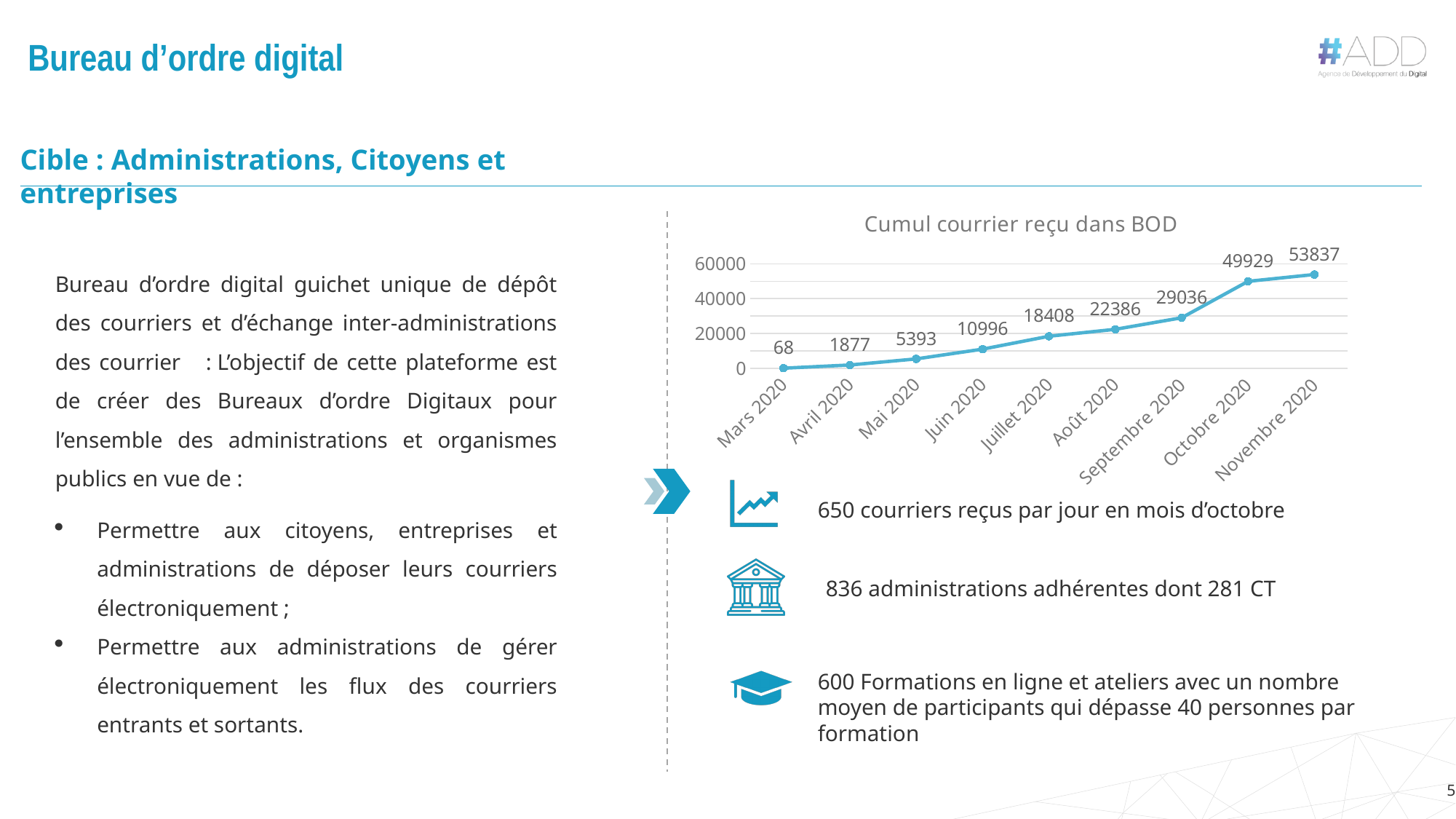
Which month has the highest value in the chart 'Cumul courrier reçu dans BOD'? Novembre 2020 What is the value for Juillet 2020 in the chart 'Cumul courrier reçu dans BOD'? 18408 Do the values in the chart 'Cumul courrier reçu dans BOD' rise or fall from Mars 2020 to Novembre 2020? rise Which is larger in the chart 'Cumul courrier reçu dans BOD': the value for Juin 2020 or the value for Août 2020? Août 2020 Which month has the lowest value in the chart 'Cumul courrier reçu dans BOD'? Mars 2020 What is the value for Novembre 2020 in the chart 'Cumul courrier reçu dans BOD'? 53837 What is the value for Mars 2020 in the chart 'Cumul courrier reçu dans BOD'? 68 Is the value for Septembre 2020 in the chart 'Cumul courrier reçu dans BOD' greater or less than 20000? greater How many months are plotted in the chart 'Cumul courrier reçu dans BOD'? 9 What kind of chart is 'Cumul courrier reçu dans BOD'? line chart What is the title of the chart on the slide? Cumul courrier reçu dans BOD What is the difference between the values for Octobre 2020 and Septembre 2020 in the chart 'Cumul courrier reçu dans BOD'? 20893